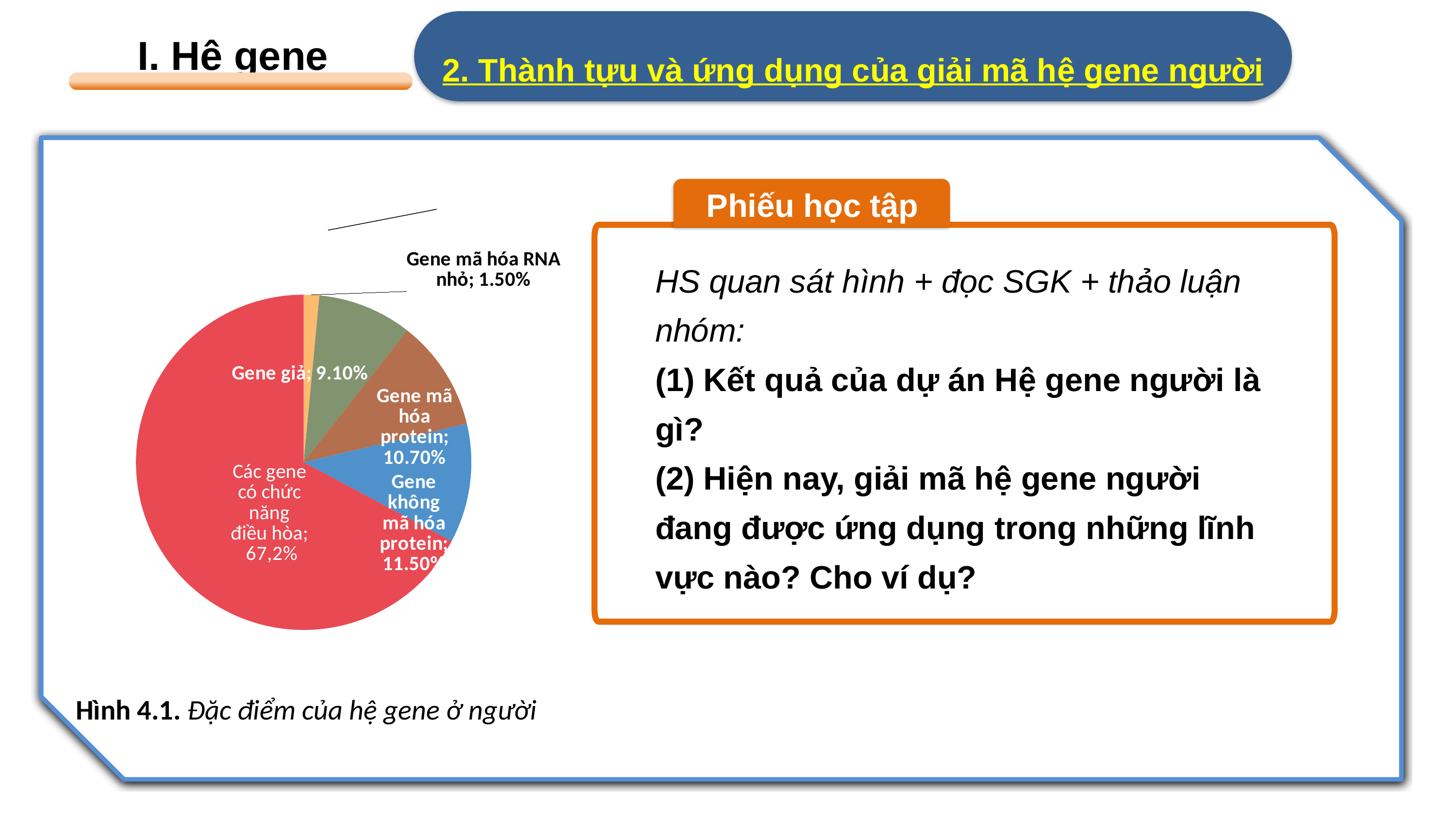
How many slices does the pie chart have? 5 What is the value shown for "Các gene có chức năng điều hòa" in the pie chart? 67,2% What is the value shown for "Gene mã hóa protein" in the pie chart? 10.70% What is the value shown for "Gene mã hóa RNA nhỏ" in the pie chart? 1.50% What is the figure caption below the pie chart? Hình 4.1. Đặc điểm của hệ gene ở người What is the difference between the values for "Gene không mã hóa protein" and "Gene mã hóa protein" in the pie chart? 0.80% What is the value shown for "Gene giả" in the pie chart? 9.10% What kind of chart is shown on the slide? pie chart What is the value shown for "Gene không mã hóa protein" in the pie chart? 11.50% Which slice of the pie chart is the largest? Các gene có chức năng điều hòa Which is larger in the pie chart: "Gene giả" or "Gene không mã hóa protein"? Gene không mã hóa protein Which slice of the pie chart is the smallest? Gene mã hóa RNA nhỏ